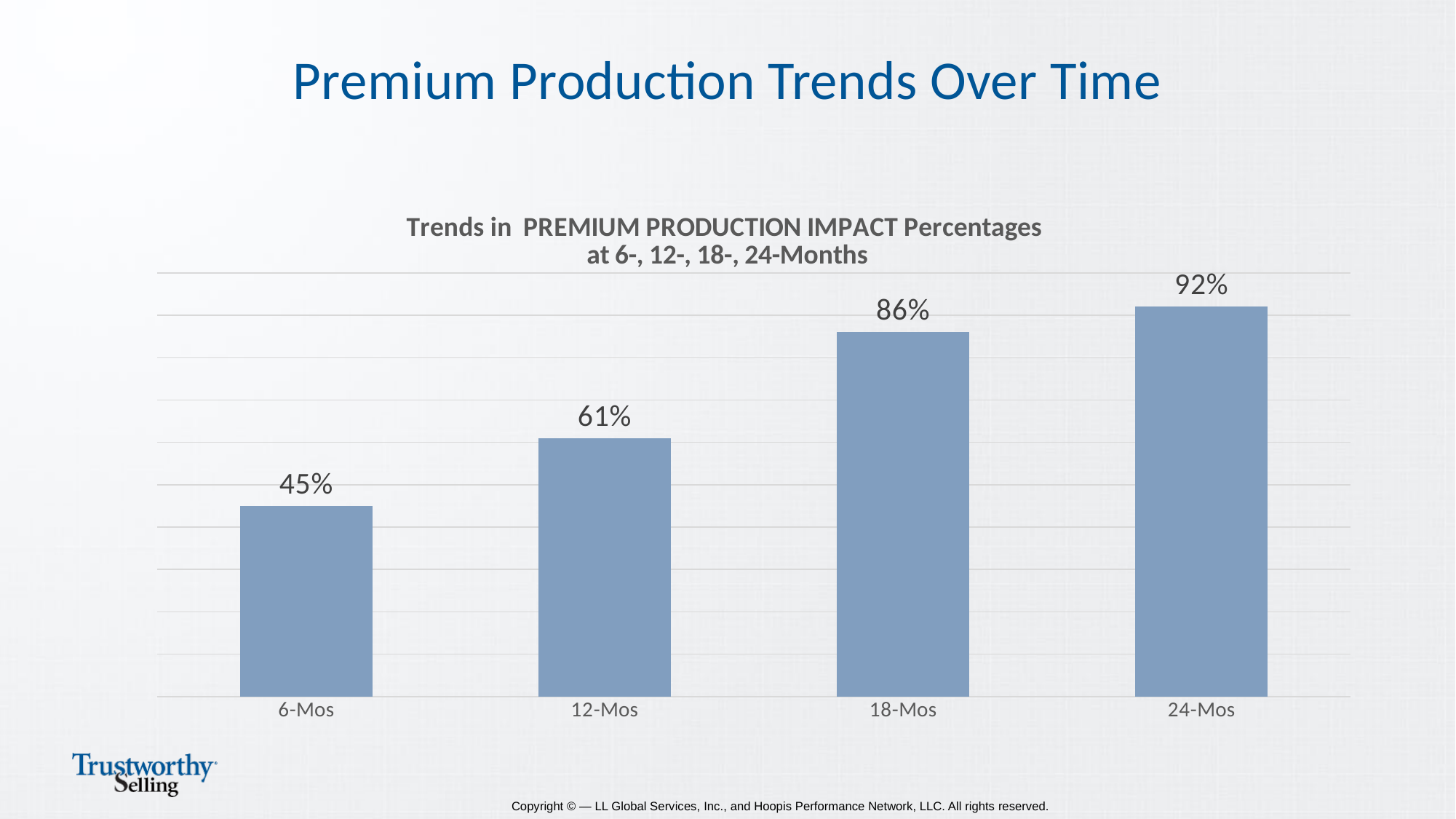
What is the difference between the 18-Mos and 12-Mos percentages? 25% Which is larger, the value at 12-Mos or the value at 18-Mos? 18-Mos What is the premium production impact percentage at 12-Mos? 61% Do the values rise or fall from 6-Mos to 24-Mos? Rise What is the premium production impact percentage at 18-Mos? 86% What is the difference between the 24-Mos and 6-Mos percentages? 47% Which time period has the lowest premium production impact percentage? 6-Mos What is the premium production impact percentage at 24-Mos? 92% Which time period has the highest premium production impact percentage? 24-Mos How many time periods are shown on the chart? 4 What kind of chart is shown on the slide? Bar chart What is the premium production impact percentage at 6-Mos? 45%